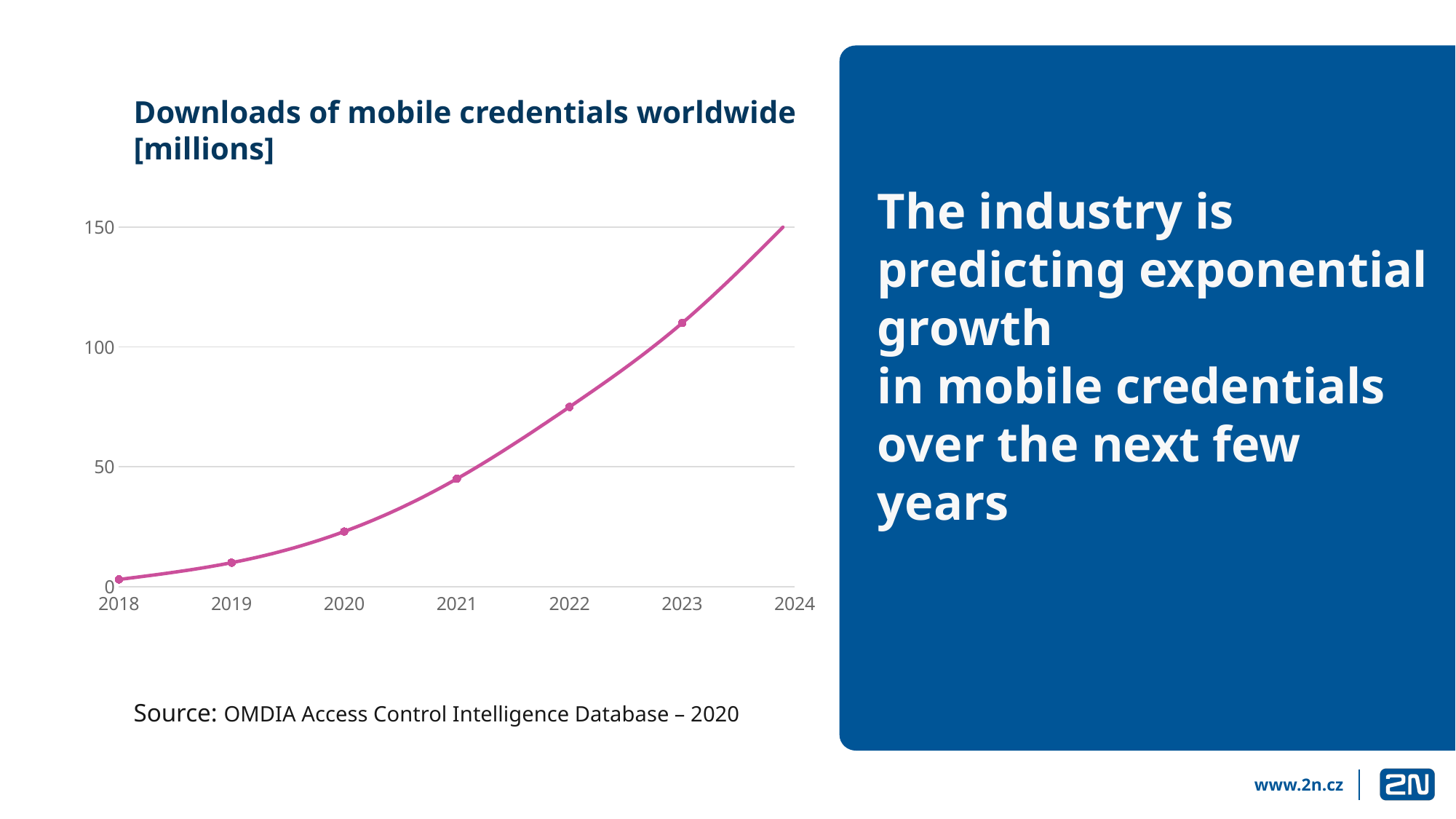
Is the value for 2021 greater or less than 50? less Which year has the lowest value on the chart? 2018 What kind of chart is shown on the slide? line chart What is the title of the chart? Downloads of mobile credentials worldwide [millions] Which year has the highest value on the chart? 2024 Is the value for 2023 greater or less than 100? greater Which year has the larger value, 2021 or 2023? 2023 What source is cited below the chart? OMDIA Access Control Intelligence Database – 2020 Is the value for 2022 greater or less than 50? greater How many years are plotted on the x axis of the chart? 7 Do the values rise or fall from 2018 to 2024? rise